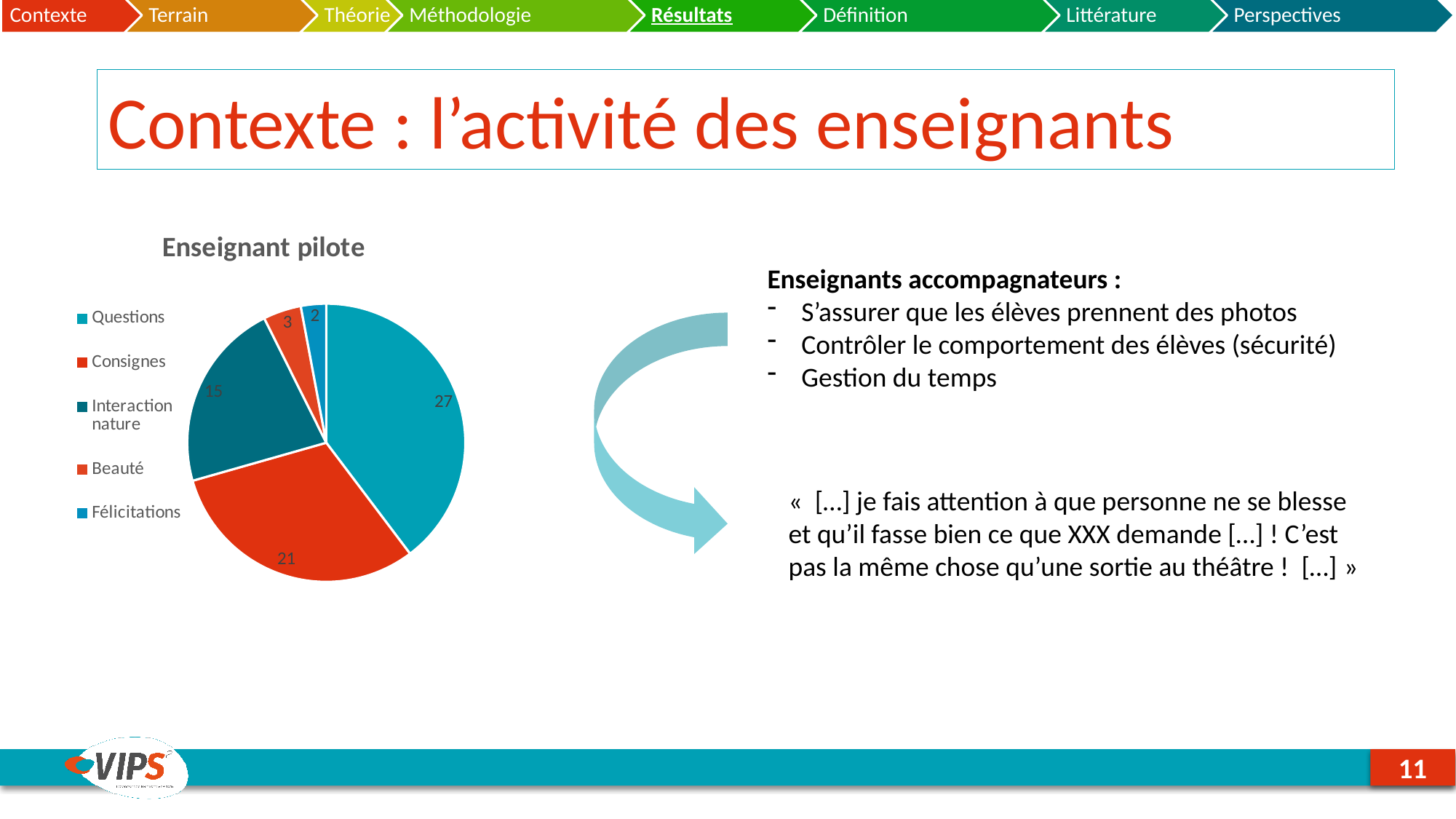
What is the value for Consignes in the pie chart? 21 What is the title of the chart? Enseignant pilote What is the total of all the values in the pie chart? 68 What is the value for Félicitations in the pie chart? 2 Which category has the smallest slice in the pie chart? Félicitations What is the value for Interaction nature in the pie chart? 15 Which category has the largest slice in the pie chart? Questions What is the difference between the values for Questions and Consignes? 6 What is the value for Questions in the pie chart? 27 What type of chart is shown on the slide? pie chart Which is larger, the value for Beauté or the value for Interaction nature? Interaction nature How many categories does the pie chart have? 5